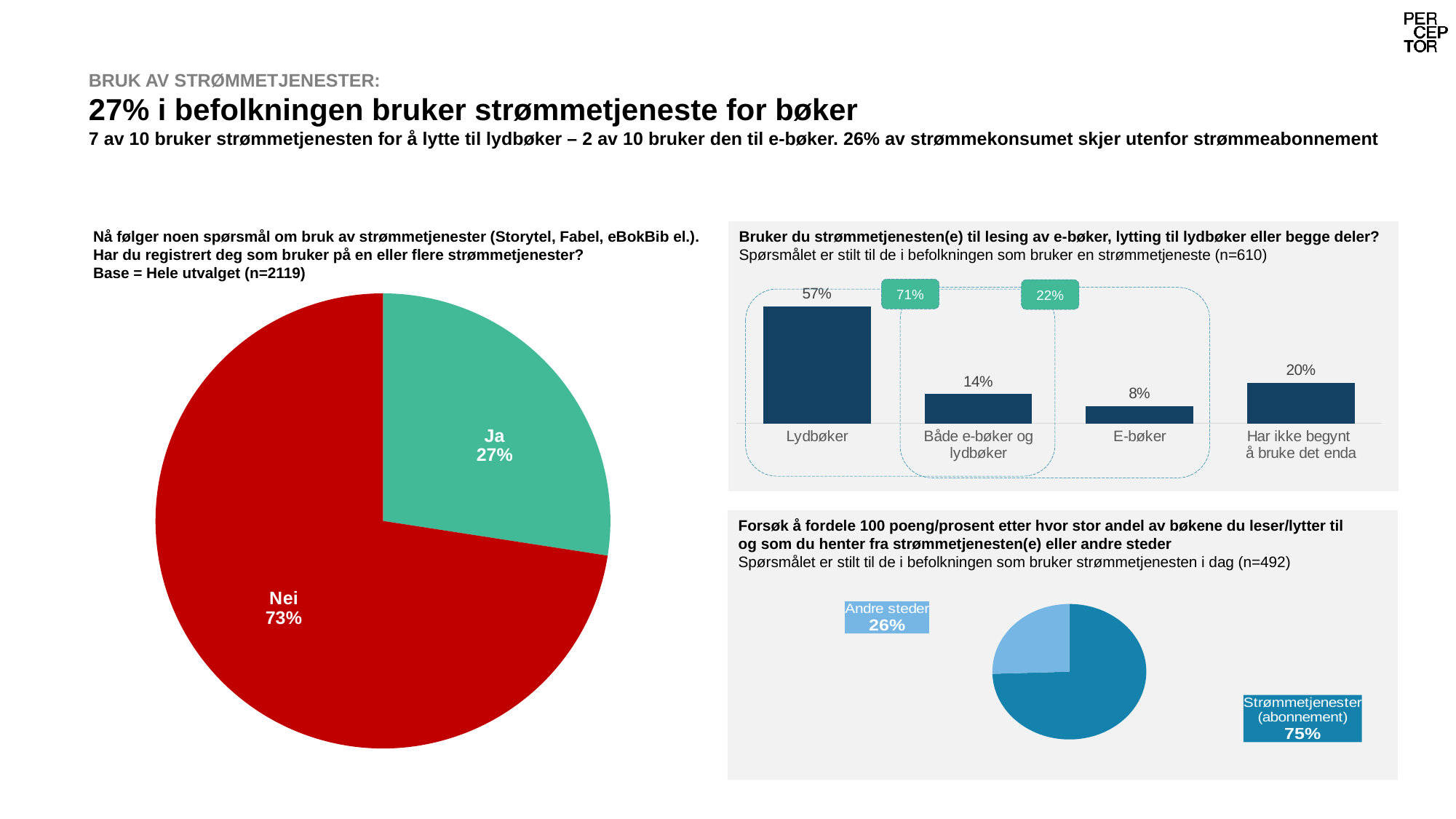
In the large pie chart on the left, what share of respondents answered "Ja"? 27% In the small pie chart at the bottom right, what share is attributed to "Strømmetjenester (abonnement)"? 75% In the bar chart at the top right, how many categories are shown? 4 In the bar chart at the top right, which category has the highest value? Lydbøker In the bar chart at the top right, which category has the lowest value? E-bøker In the large pie chart on the left, which slice is larger, "Ja" or "Nei"? Nei In the bar chart at the top right, what is the value for "Lydbøker"? 57% In the bar chart at the top right, what is the value for "E-bøker"? 8% In the bar chart at the top right, what is the difference between "Lydbøker" and "Har ikke begynt å bruke det enda"? 37% In the large pie chart on the left, how many slices are there? 2 In the large pie chart on the left, what share of respondents answered "Nei"? 73% What type of chart is shown at the top right of the slide? Bar chart